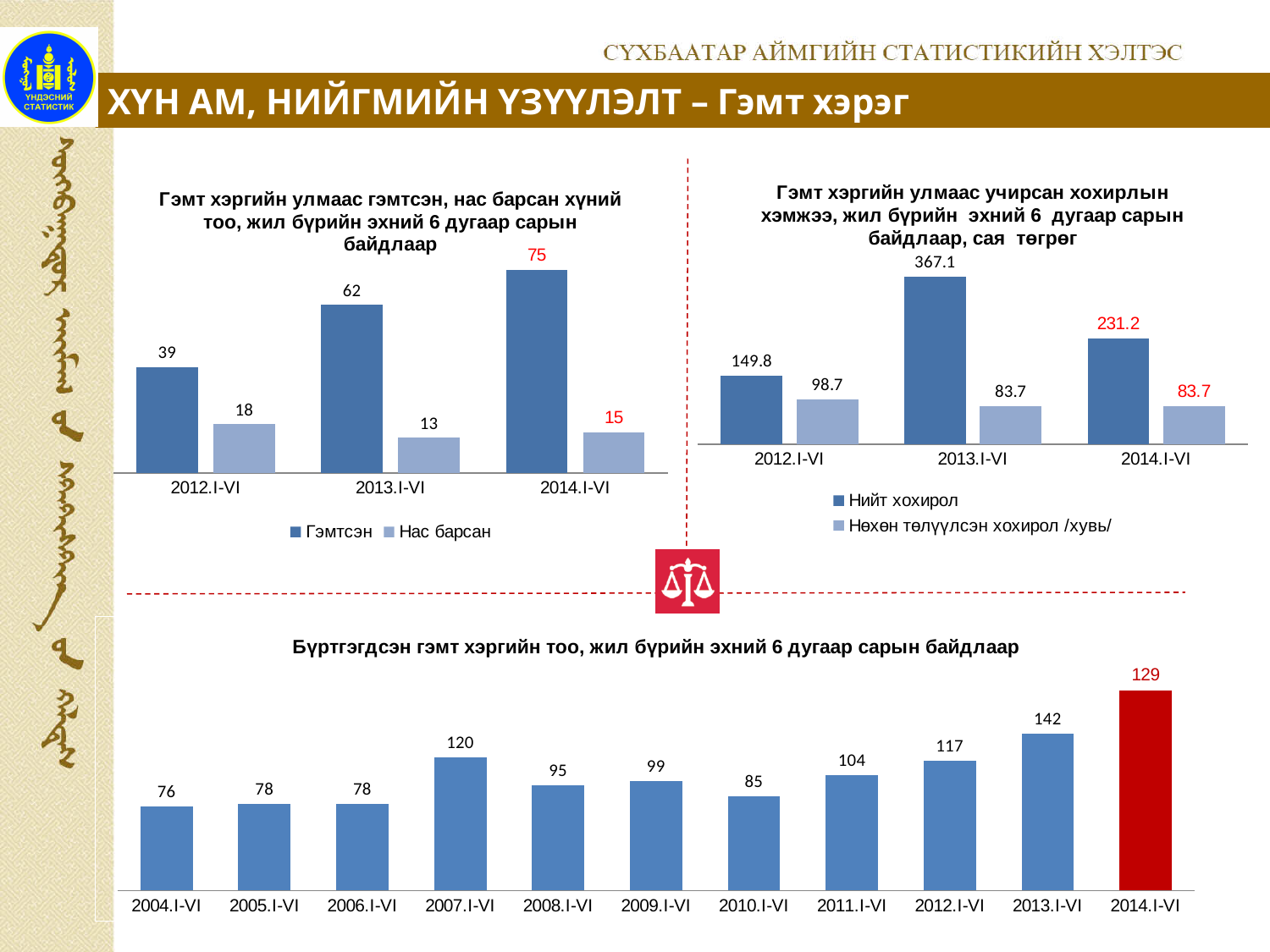
In the top-left chart, how many series does the legend list? 2 In the top-right chart, what is the Нөхөн төлүүлсэн хохирол /хувь/ value for 2012.I-VI? 98.7 In the top-right chart, is the Нийт хохирол value larger in 2013.I-VI or 2014.I-VI? 2013.I-VI In the bottom chart, what is the value for 2007.I-VI? 120 In the top-right chart, which period has the lowest Нийт хохирол value? 2012.I-VI In the top-right chart, what is the Нийт хохирол value for 2013.I-VI? 367.1 In the top-left chart, what is the difference between the Гэмтсэн and Нас барсан values in 2014.I-VI? 60 In the top-left chart, what is the value for Нас барсан in 2012.I-VI? 18 In the bottom chart, how many periods are shown on the x axis? 11 In the top-left chart, what is the value for Гэмтсэн in 2013.I-VI? 62 In the top-left chart, which period has the highest Гэмтсэн value? 2014.I-VI In the bottom chart, which period has the lowest value? 2004.I-VI